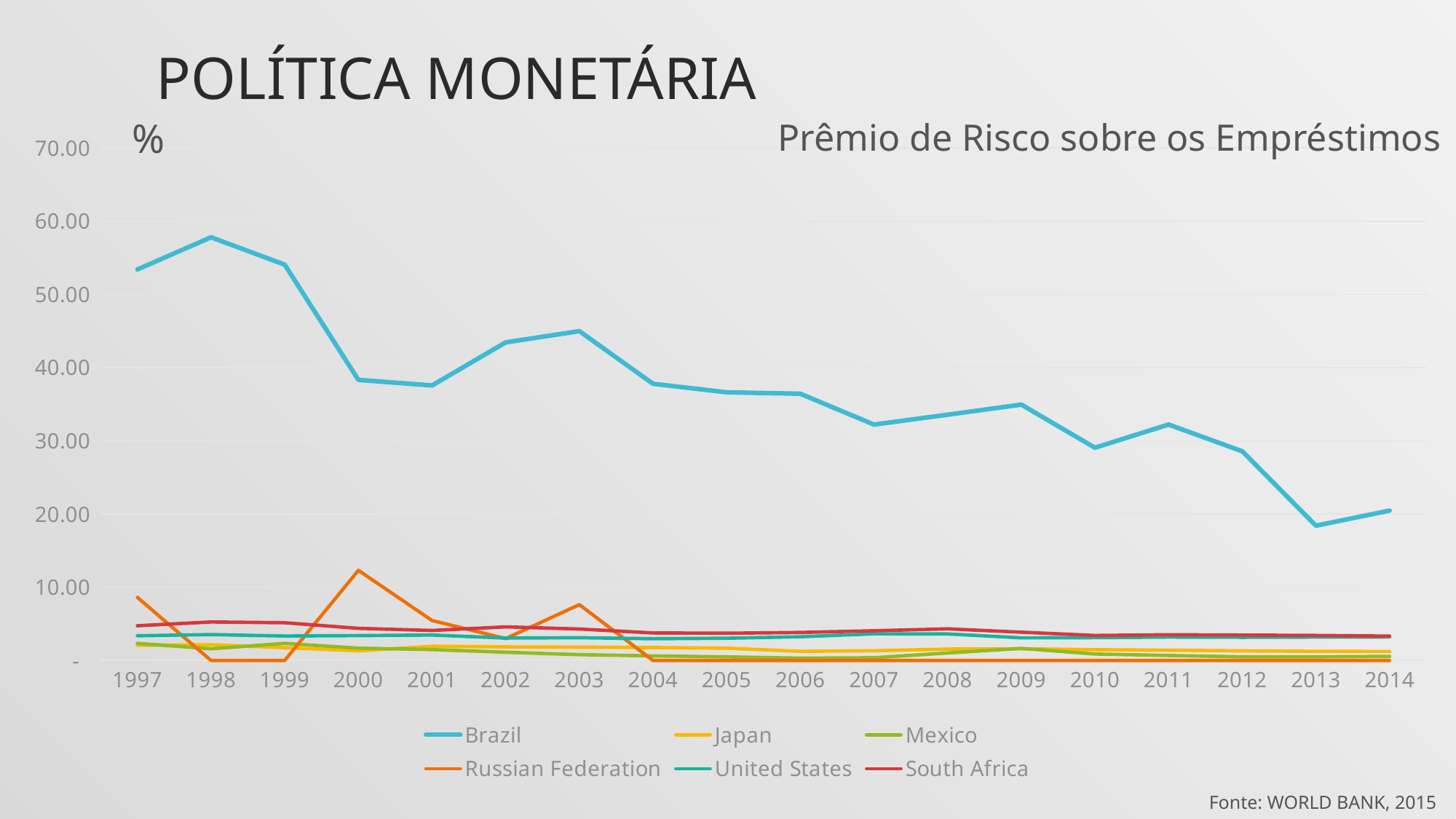
Does the Brazil line generally rise or fall from 1997 to 2014? Fall Which is larger for the Russian Federation: the value in 2000 or the value in 2003? 2000 What is the source cited for the chart data? WORLD BANK, 2015 Is the value for Brazil in 1998 greater or less than 50.00? greater How many series does the legend list? 6 In which year does the Brazil line reach its highest value? 1998 Is the value for Russian Federation in 2000 greater or less than 10.00? greater What kind of chart is shown on the slide? Line chart How many years are shown on the x axis? 18 In which year does the Brazil line reach its lowest value? 2013 Is the value for Brazil in 2000 greater or less than 40.00? less Which country has the highest risk premium in 1997? Brazil